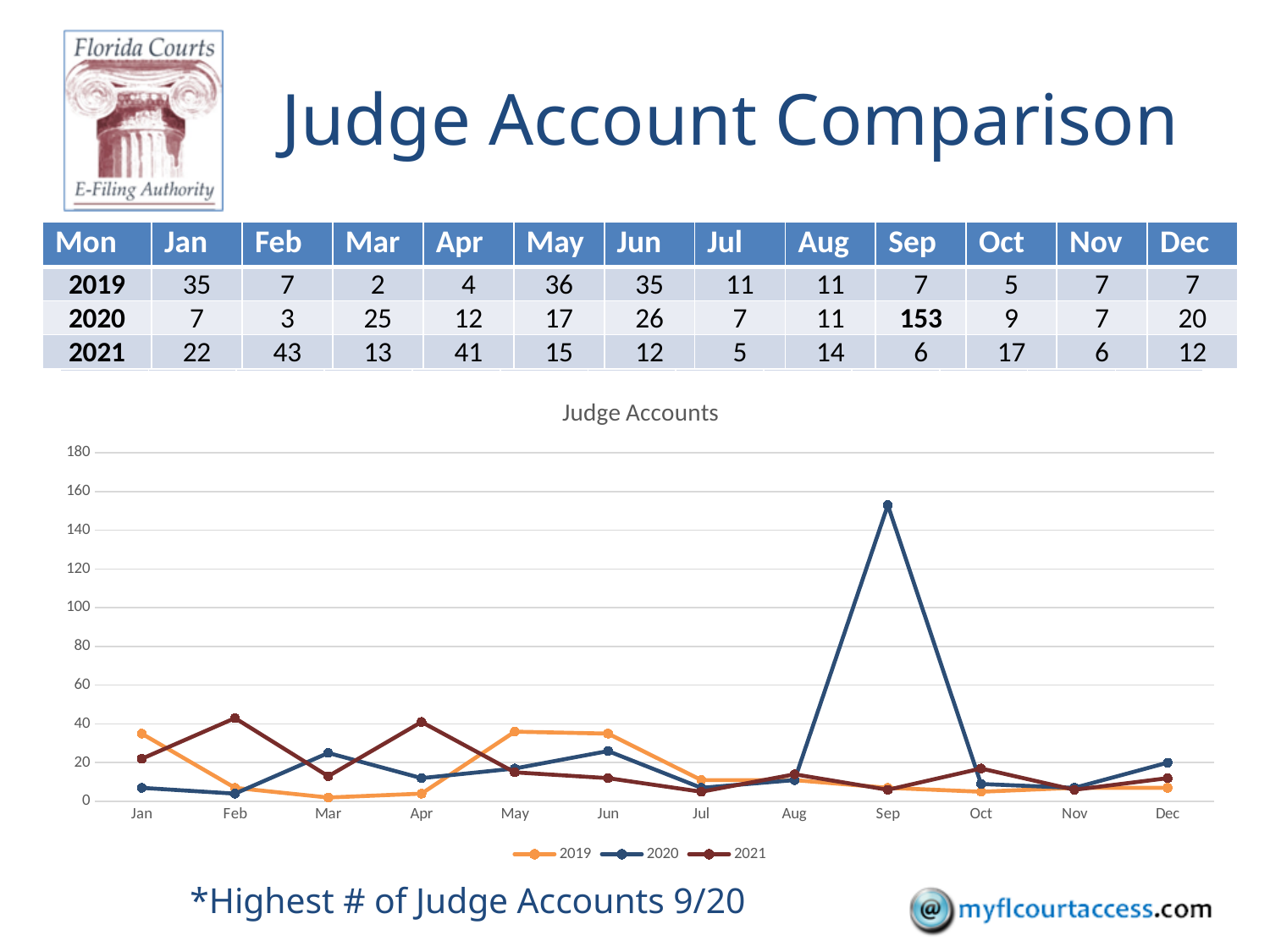
Which series has the larger value in Apr, 2019 or 2021? 2021 What is the value for 2020 in Sep on the Judge Accounts chart? 153 How many months are shown on the x axis of the Judge Accounts chart? 12 In which month does the 2020 series reach its highest value? Sep Is the value for 2020 in Sep greater or less than 140? greater What is the value for 2021 in Feb on the Judge Accounts chart? 43 Does the 2020 series rise or fall from Sep to Oct? fall How many series does the legend of the Judge Accounts chart list? 3 What kind of chart is the Judge Accounts chart? line chart What is the difference between the 2019 values for May and Apr? 32 What is the value for 2019 in Jan on the Judge Accounts chart? 35 In which month does the 2019 series have its lowest value? Mar